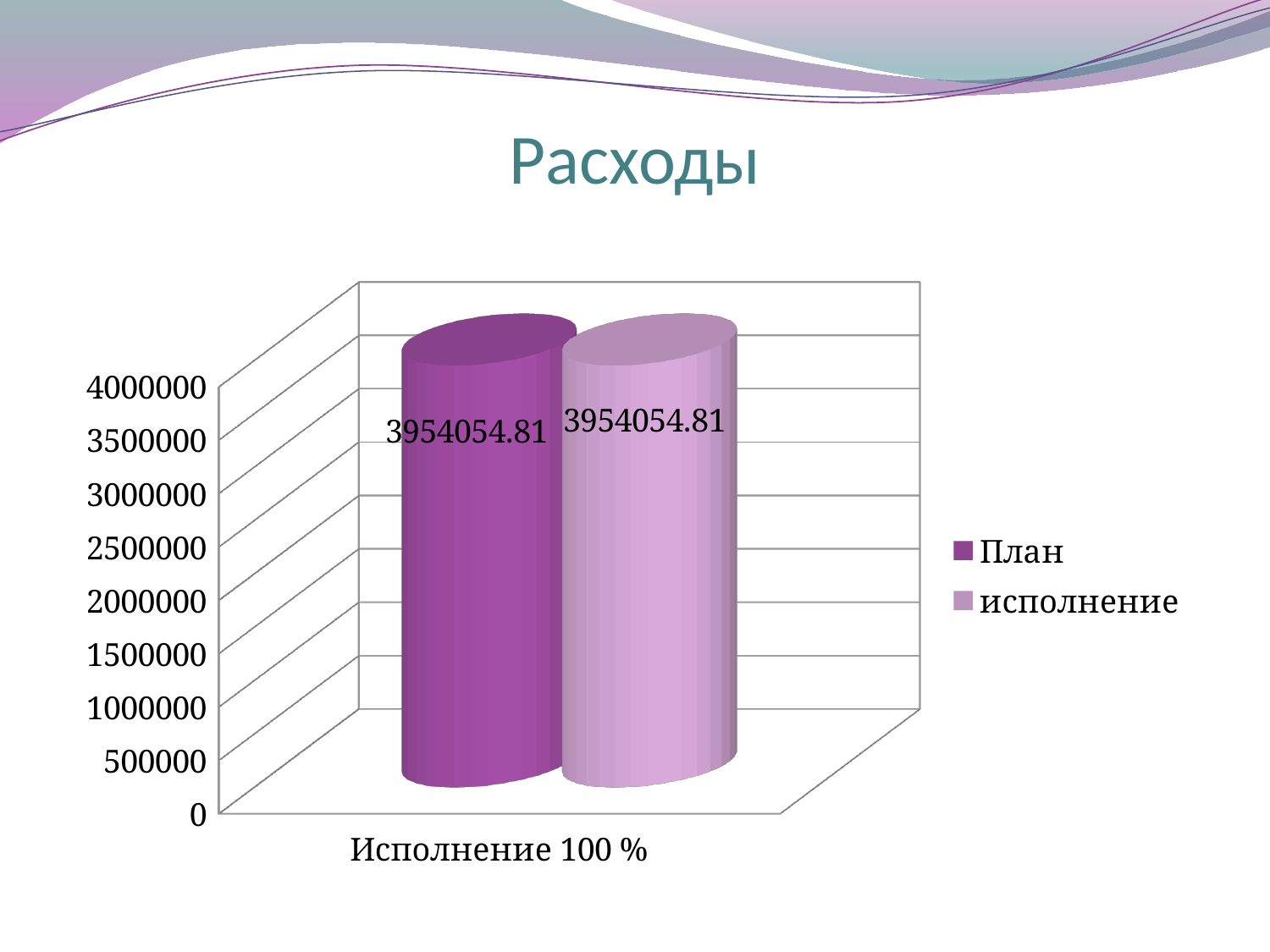
What is the highest value shown on the vertical axis? 4000000 How many categories are shown on the x axis of the chart? 1 What is the difference between the План value and the исполнение value? 0 What is the value of the План series for the category Исполнение 100 %? 3954054.81 What kind of chart is shown on the slide? bar chart What is the label of the category on the x axis? Исполнение 100 % Is the value for План greater or less than 3500000? greater How many series does the legend list? 2 Is the value for исполнение greater or less than 4000000? less What is the value of the исполнение series for the category Исполнение 100 %? 3954054.81 What is the title of the slide? Расходы